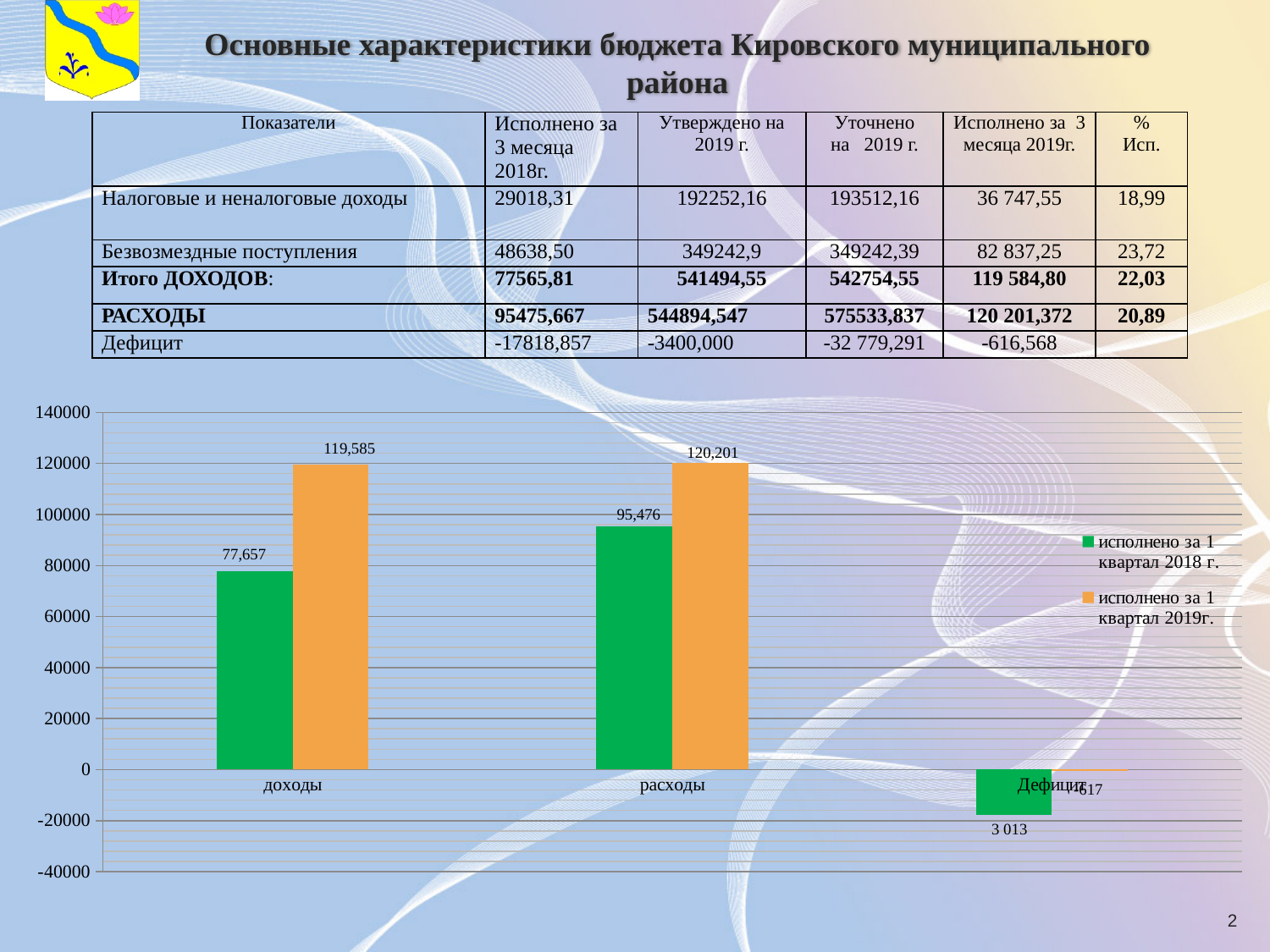
How many series does the chart legend list? 2 Is the value for расходы in the series исполнено за 1 квартал 2018 г. greater or less than 100000? less Which colour represents the series исполнено за 1 квартал 2019г. in the chart? orange Which is larger for доходы: the value for 1 квартал 2018 г. or for 1 квартал 2019г.? исполнено за 1 квартал 2019г. What is the value for доходы in the series исполнено за 1 квартал 2019г.? 119,585 How many categories are shown on the x axis of the chart? 3 What is the value for расходы in the series исполнено за 1 квартал 2019г.? 120,201 What is the value for расходы in the series исполнено за 1 квартал 2018 г.? 95,476 What is the difference between the расходы and доходы values in the series исполнено за 1 квартал 2018 г.? 17,819 What is the value for доходы in the series исполнено за 1 квартал 2018 г.? 77,657 What type of chart is shown on the slide? bar chart Which category has the highest value in the series исполнено за 1 квартал 2019г.? расходы